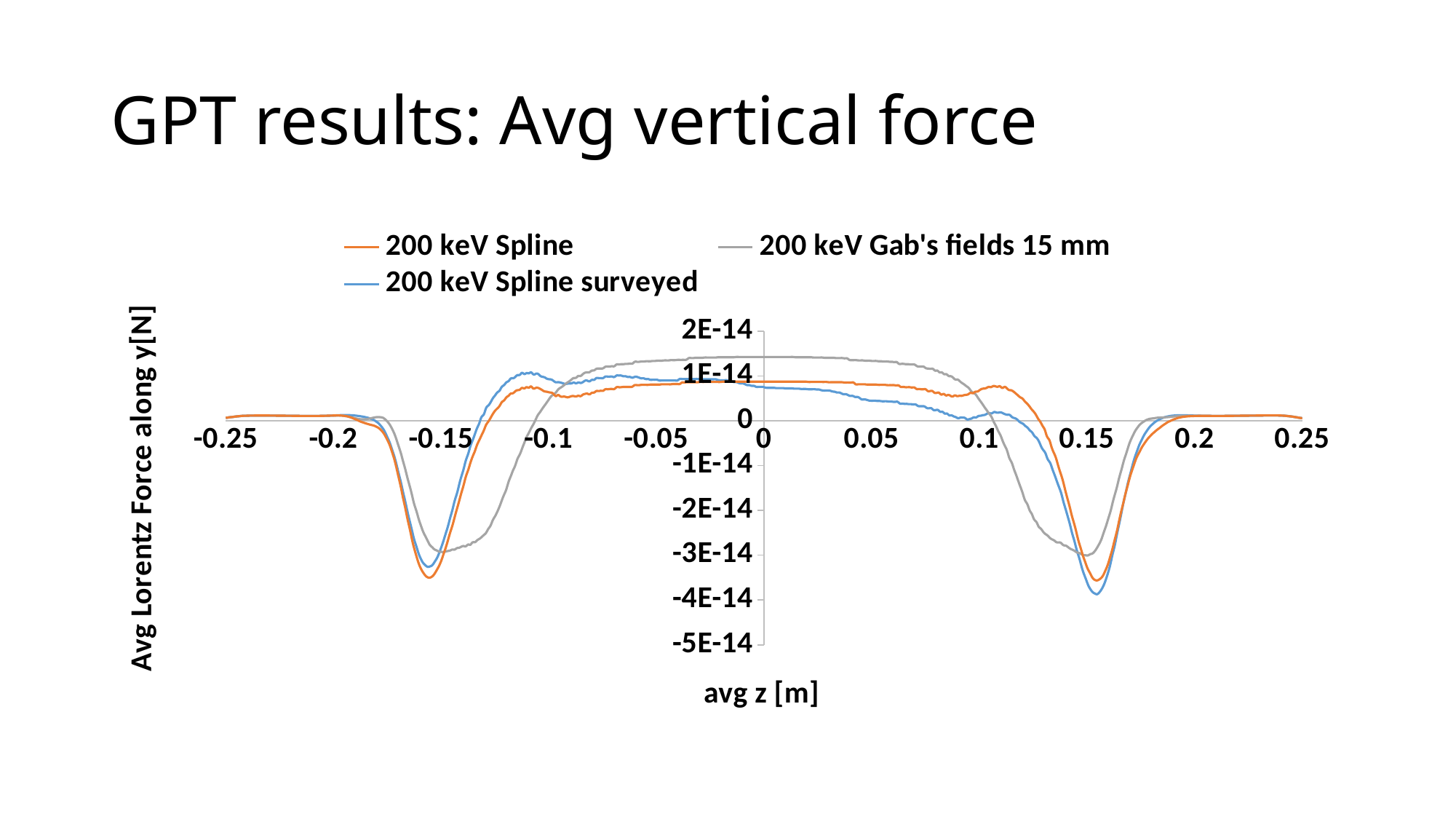
How many series does the legend list? 3 Is the minimum value of the 200 keV Spline series near avg z = -0.15 greater or less than -3E-14? less Which series has the highest value at avg z = 0? 200 keV Gab's fields 15 mm Which series has the shallowest (least negative) dip near avg z = 0.15? 200 keV Gab's fields 15 mm Is the minimum value of the 200 keV Spline surveyed series near avg z = 0.15 greater or less than -3E-14? less Between avg z = -0.15 and avg z = -0.1, does the 200 keV Spline surveyed series rise or fall? rise What is the label of the y axis? Avg Lorentz Force along y [N] Between avg z = 0.1 and avg z = 0.15, does the 200 keV Spline series rise or fall? fall What is the label of the x axis? avg z [m] What kind of chart is shown on the slide? line chart Is the value of the 200 keV Gab's fields 15 mm series at avg z = 0 greater or less than 1E-14? greater